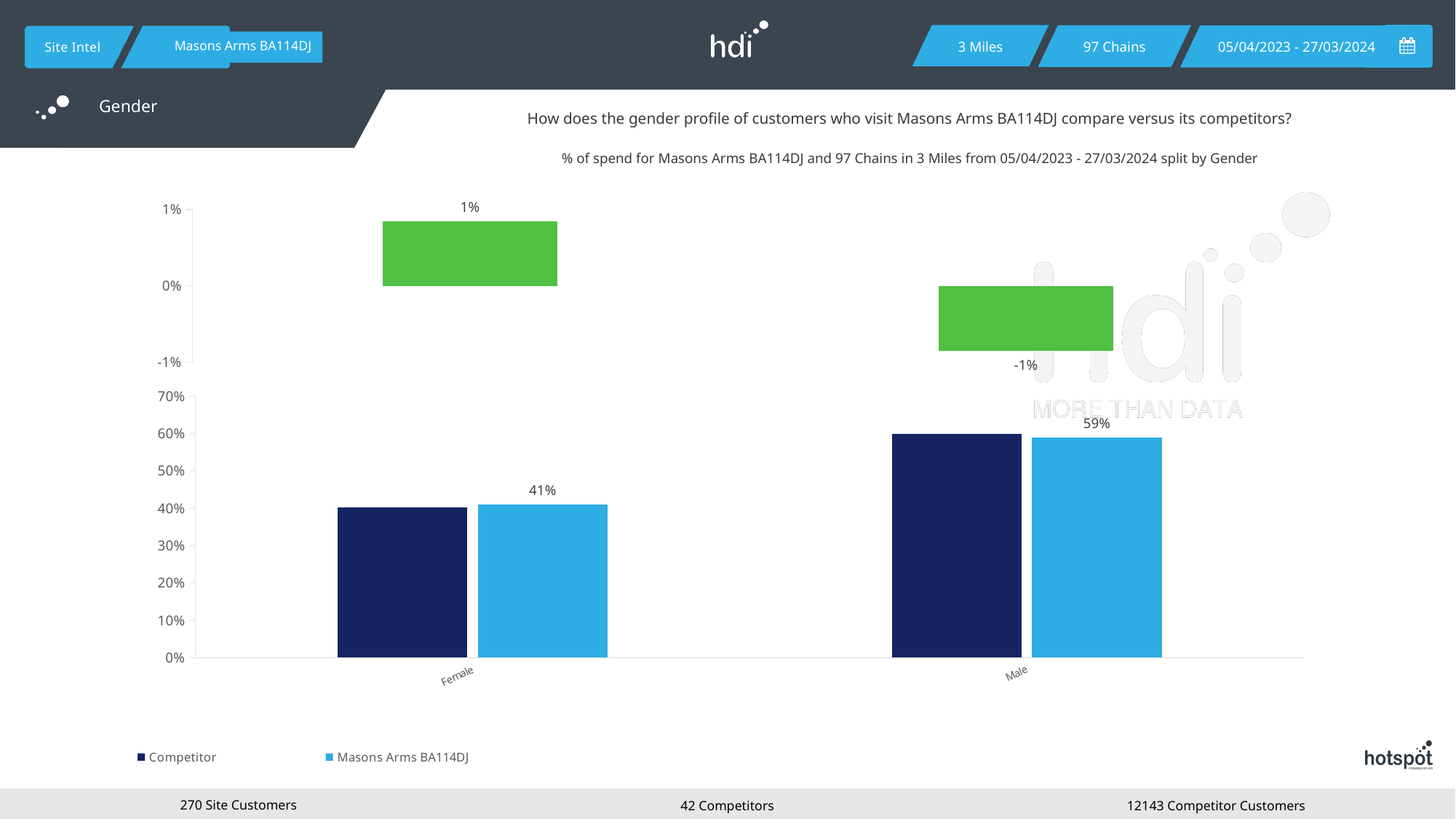
In the bottom chart, what is the value for Masons Arms BA114DJ for Female? 41% In the top chart, what is the value shown for Male? -1% In the bottom chart, is the Competitor value for Male larger or smaller than the Competitor value for Female? larger How many gender categories are shown on the x axis of the bottom chart? 2 In the bottom chart, what is the difference between the Masons Arms BA114DJ values for Male and Female? 18% In the bottom chart, is the Competitor value for Male greater or less than 50%? greater What type of chart is the bottom chart? bar chart In the bottom chart, which gender category has the higher value for Masons Arms BA114DJ? Male In the top chart, what is the value shown for Female? 1% How many series does the legend of the bottom chart list? 2 In the bottom chart, is the Competitor value for Female greater or less than 50%? less In the bottom chart, what is the value for Masons Arms BA114DJ for Male? 59%